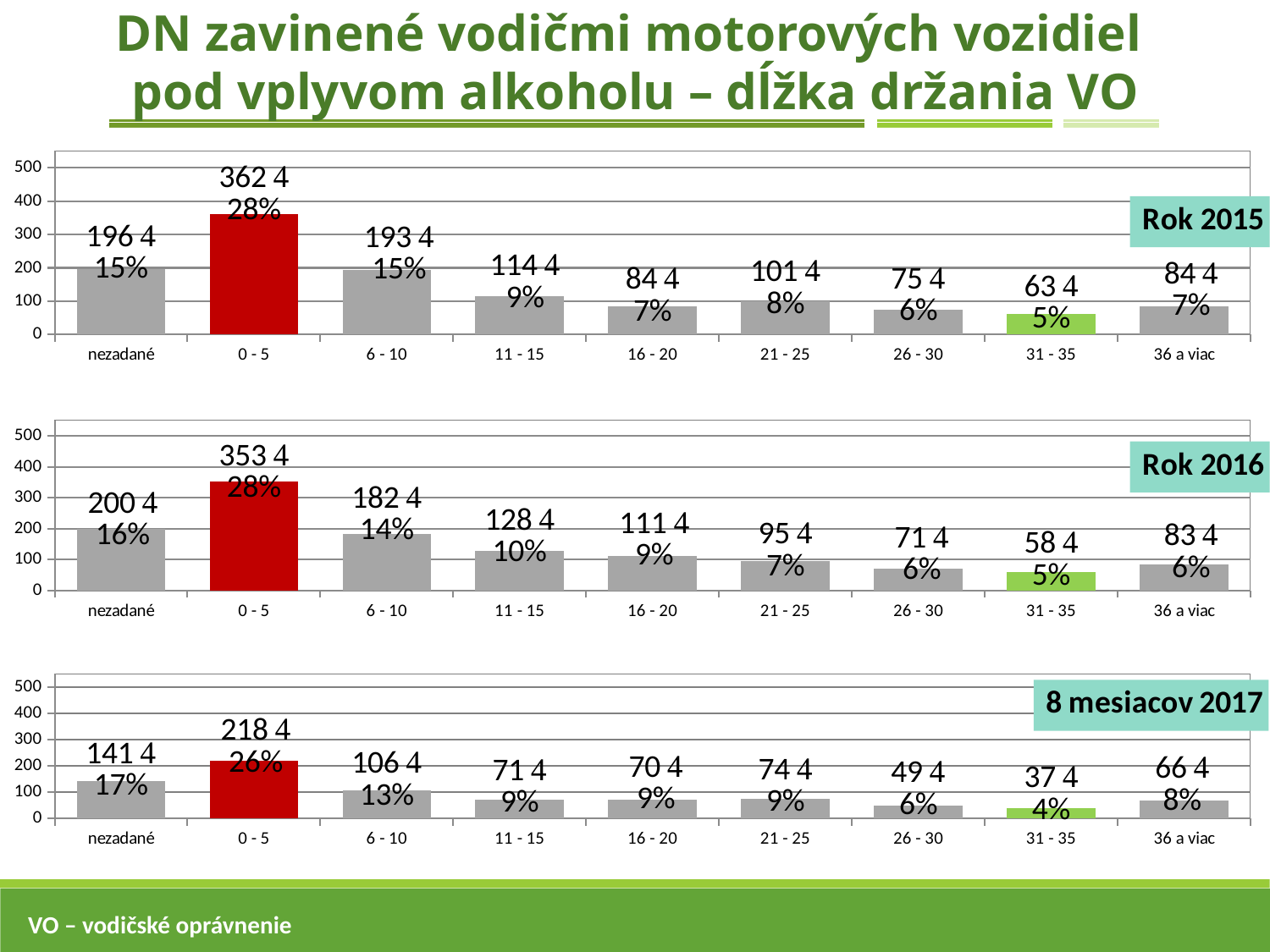
In the Rok 2016 chart, which category has the lowest bar? 31 - 35 In the Rok 2015 chart, what percentage is shown for the 0 - 5 category? 28% How many categories are shown on the x axis of the Rok 2015 chart? 9 What kind of chart is the Rok 2016 chart? bar chart In the 8 mesiacov 2017 chart, what percentage is shown for the 0 - 5 category? 26% In the 8 mesiacov 2017 chart, which is larger, the value for nezadané or the value for 6 - 10? nezadané In the Rok 2016 chart, what percentage is shown for the nezadané category? 16% In the 8 mesiacov 2017 chart, which category has the lowest bar? 31 - 35 In the Rok 2015 chart, which category has the highest bar? 0 - 5 In the Rok 2016 chart, is the value for 0 - 5 greater or less than 300? greater In the Rok 2015 chart, which category has the lowest bar? 31 - 35 In the 8 mesiacov 2017 chart, is the value for 0 - 5 greater or less than 200? greater